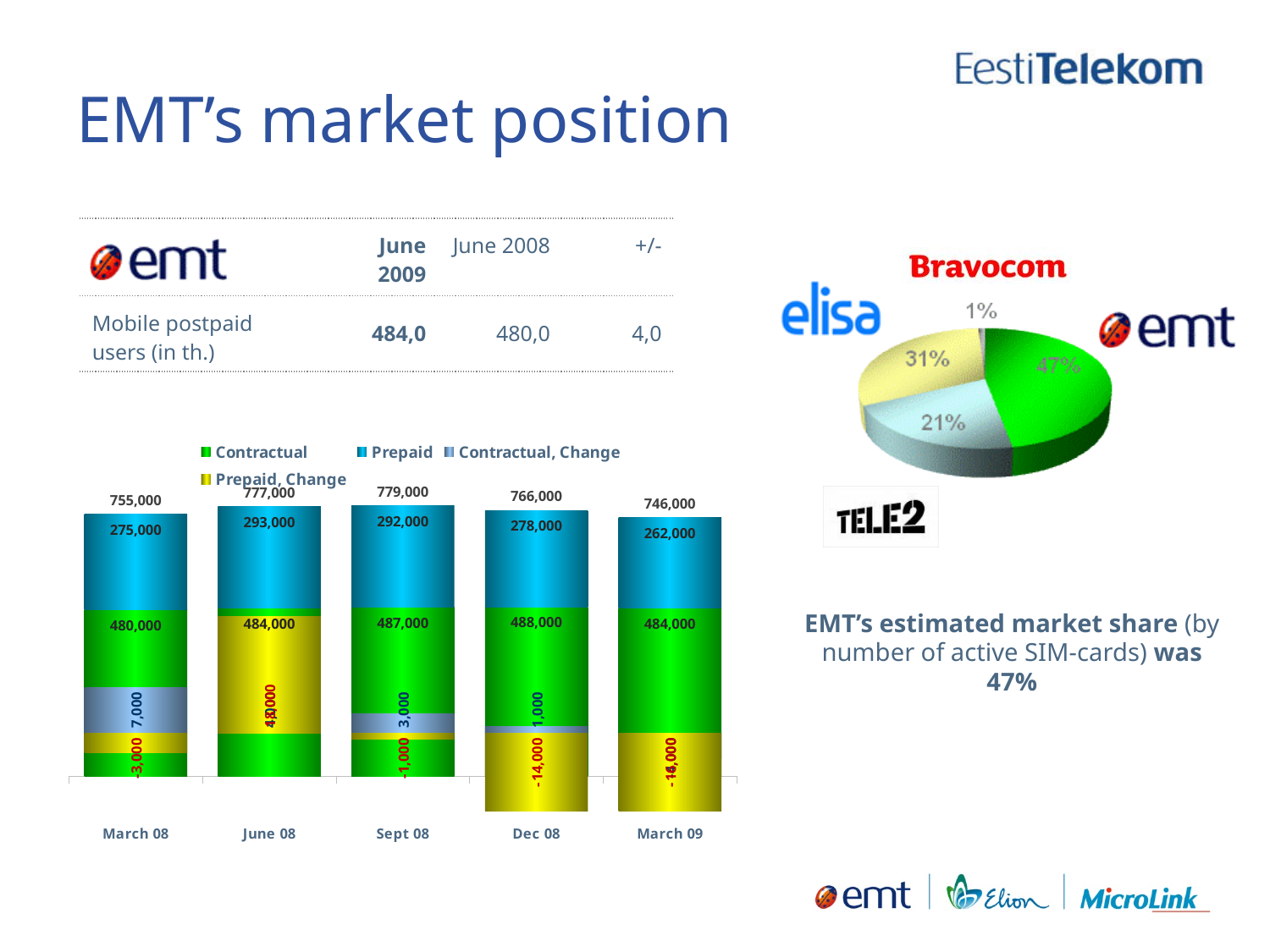
What kind of chart is the chart on the left of the slide? Stacked bar chart In the stacked bar chart, which period has the highest total? Sept 08 In the pie chart on the right, what share is shown for Elisa? 31% How many periods are shown on the x axis of the stacked bar chart? 5 In the pie chart on the right, what is EMT's share? 47% In the stacked bar chart, what is the Prepaid value for March 09? 262,000 In the stacked bar chart, what is the Contractual value for Sept 08? 487,000 In the stacked bar chart, which period has the lowest Prepaid value? March 09 In the stacked bar chart, what is the total labelled above the June 08 bar? 777,000 In the stacked bar chart, which is larger: the Contractual value for Dec 08 or for March 08? Dec 08 How many series does the legend of the stacked bar chart list? 4 In the stacked bar chart, what is the difference between the Prepaid values for June 08 and March 08? 18,000